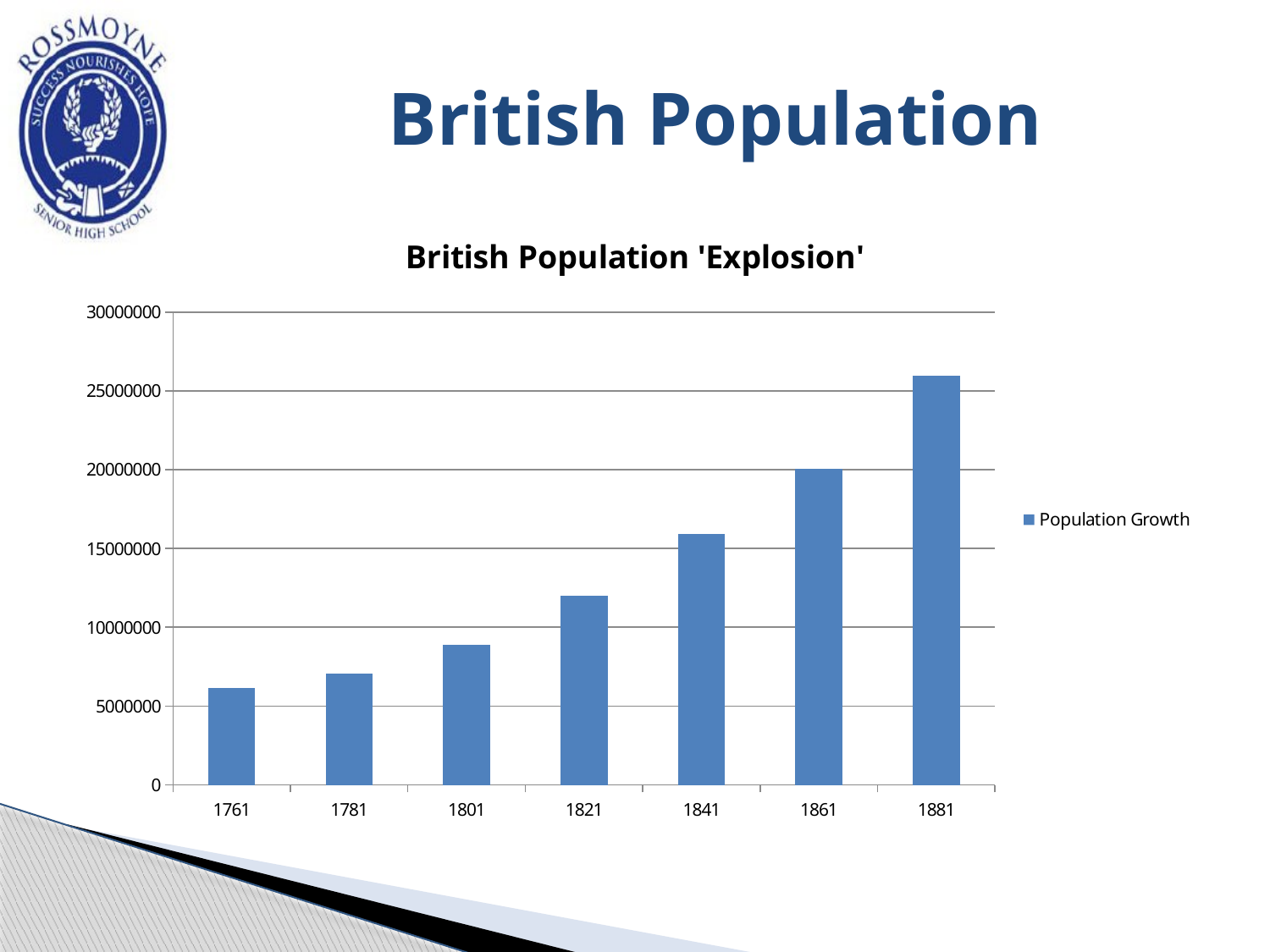
How many years are shown on the x axis? 7 Is the value for 1881 greater or less than 25000000? greater Is the value for 1841 greater or less than 15000000? greater What is the name of the series shown in the legend? Population Growth Which year has the highest population value? 1881 Do the values rise or fall from 1761 to 1881? rise What type of chart is shown on the slide? bar chart Is the value for 1761 greater or less than 10000000? less Which is larger, the value for 1821 or the value for 1801? 1821 How many series does the legend list? 1 Which year has the lowest population value? 1761 What is the title of the chart? British Population 'Explosion'